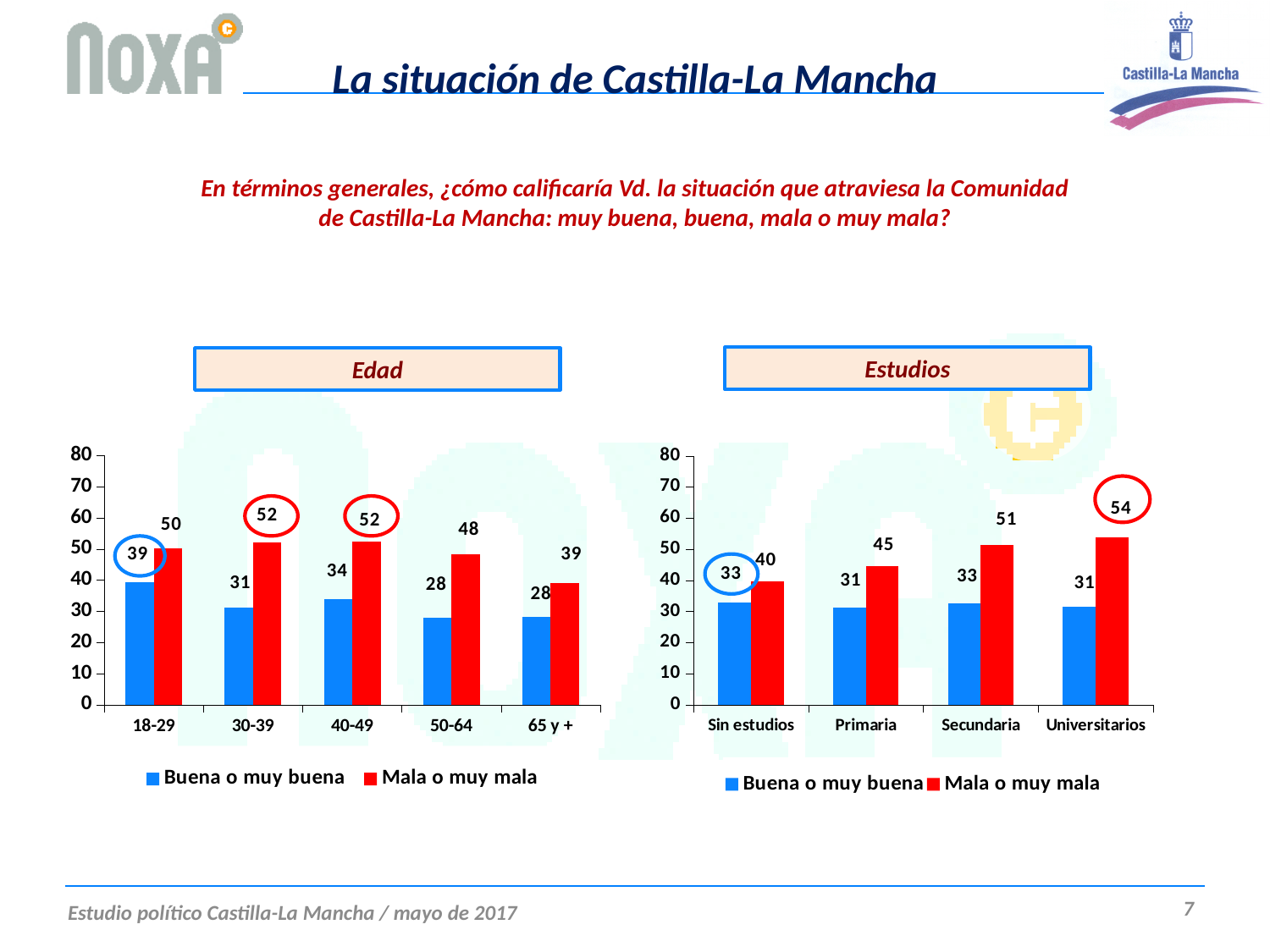
In the Edad chart, how many age groups are shown on the x axis? 5 In the Estudios chart, what is the value of 'Mala o muy mala' for Universitarios? 54 In the Estudios chart, how many series does the legend list? 2 What type of chart is the Estudios chart? bar chart In the Estudios chart, what is the value of 'Buena o muy buena' for Sin estudios? 33 In the Edad chart, what is the value of 'Buena o muy buena' for the 18-29 age group? 39 In the Estudios chart, is the 'Mala o muy mala' value for Primaria larger or smaller than the 'Mala o muy mala' value for Secundaria? smaller In the Edad chart, which age group has the lowest 'Mala o muy mala' value? 65 y + In the Edad chart, which age group has the highest 'Buena o muy buena' value? 18-29 In the Edad chart, what is the value of 'Mala o muy mala' for the 30-39 age group? 52 In the Edad chart, what is the difference between 'Mala o muy mala' and 'Buena o muy buena' for the 50-64 age group? 20 In the Estudios chart, which education level has the highest 'Mala o muy mala' value? Universitarios